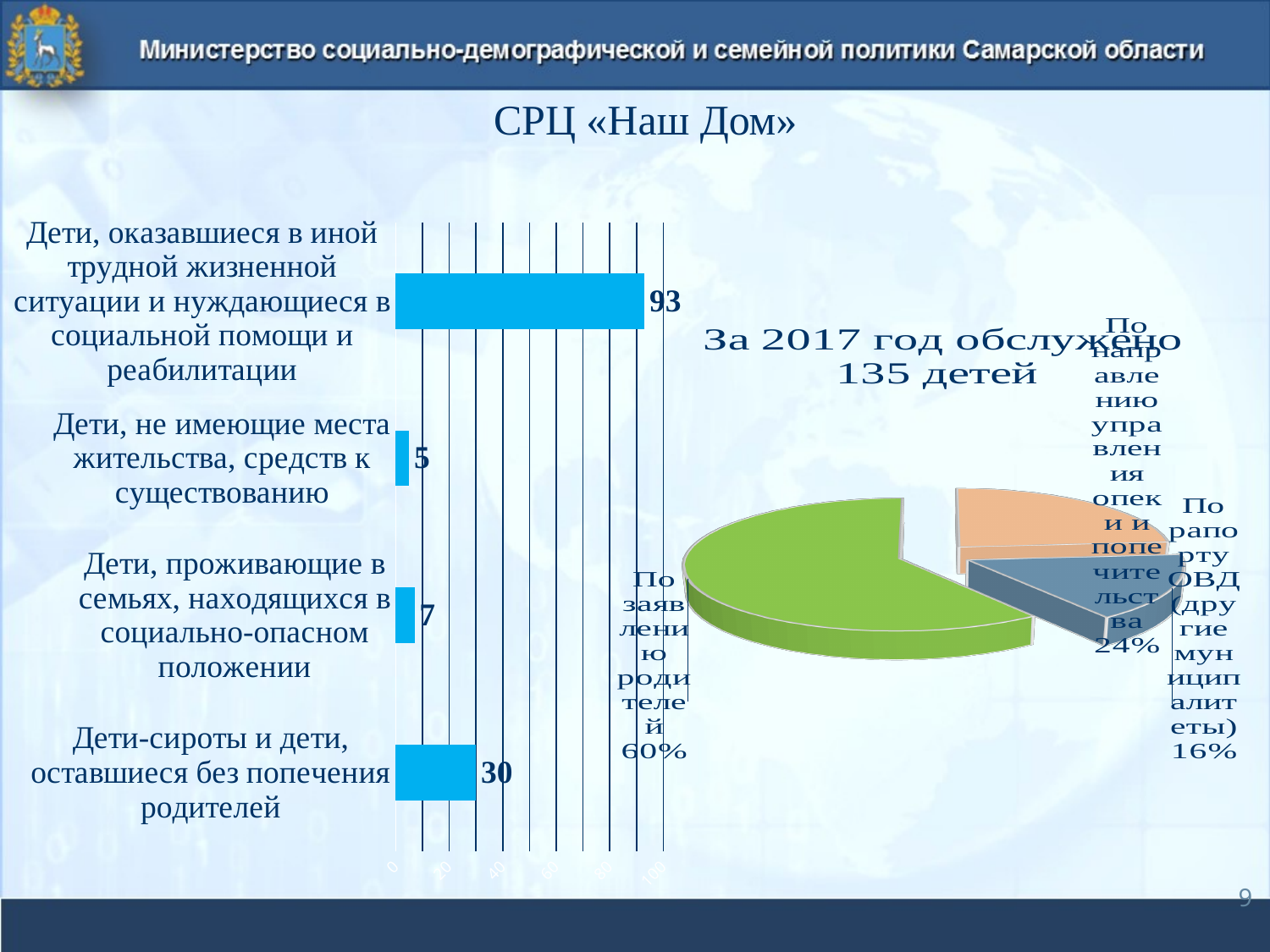
On the bar chart on the left, what is the value for «Дети, не имеющие места жительства, средств к существованию»? 5 On the bar chart on the left, which category has the highest value? Дети, оказавшиеся в иной трудной жизненной ситуации и нуждающиеся в социальной помощи и реабилитации On the bar chart on the left, which is larger: the value for «Дети, проживающие в семьях, находящихся в социально-опасном положении» or for «Дети, не имеющие места жительства, средств к существованию»? Дети, проживающие в семьях, находящихся в социально-опасном положении On the bar chart on the left, what is the value for «Дети-сироты и дети, оставшиеся без попечения родителей»? 30 On the pie chart «За 2017 год обслужено 135 детей», which slice is the largest? По заявлению родителей On the bar chart on the left, what is the value for «Дети, оказавшиеся в иной трудной жизненной ситуации и нуждающиеся в социальной помощи и реабилитации»? 93 On the bar chart on the left, which category has the lowest value? Дети, не имеющие места жительства, средств к существованию On the pie chart «За 2017 год обслужено 135 детей», what share is «По заявлению родителей»? 60% What type of chart is shown on the left of the slide? Bar chart On the pie chart «За 2017 год обслужено 135 детей», what share is «По рапорту ОВД (другие муниципалитеты)»? 16% How many categories does the bar chart on the left show? 4 On the bar chart on the left, what is the difference between the values for «Дети, оказавшиеся в иной трудной жизненной ситуации...» and «Дети-сироты и дети, оставшиеся без попечения родителей»? 63